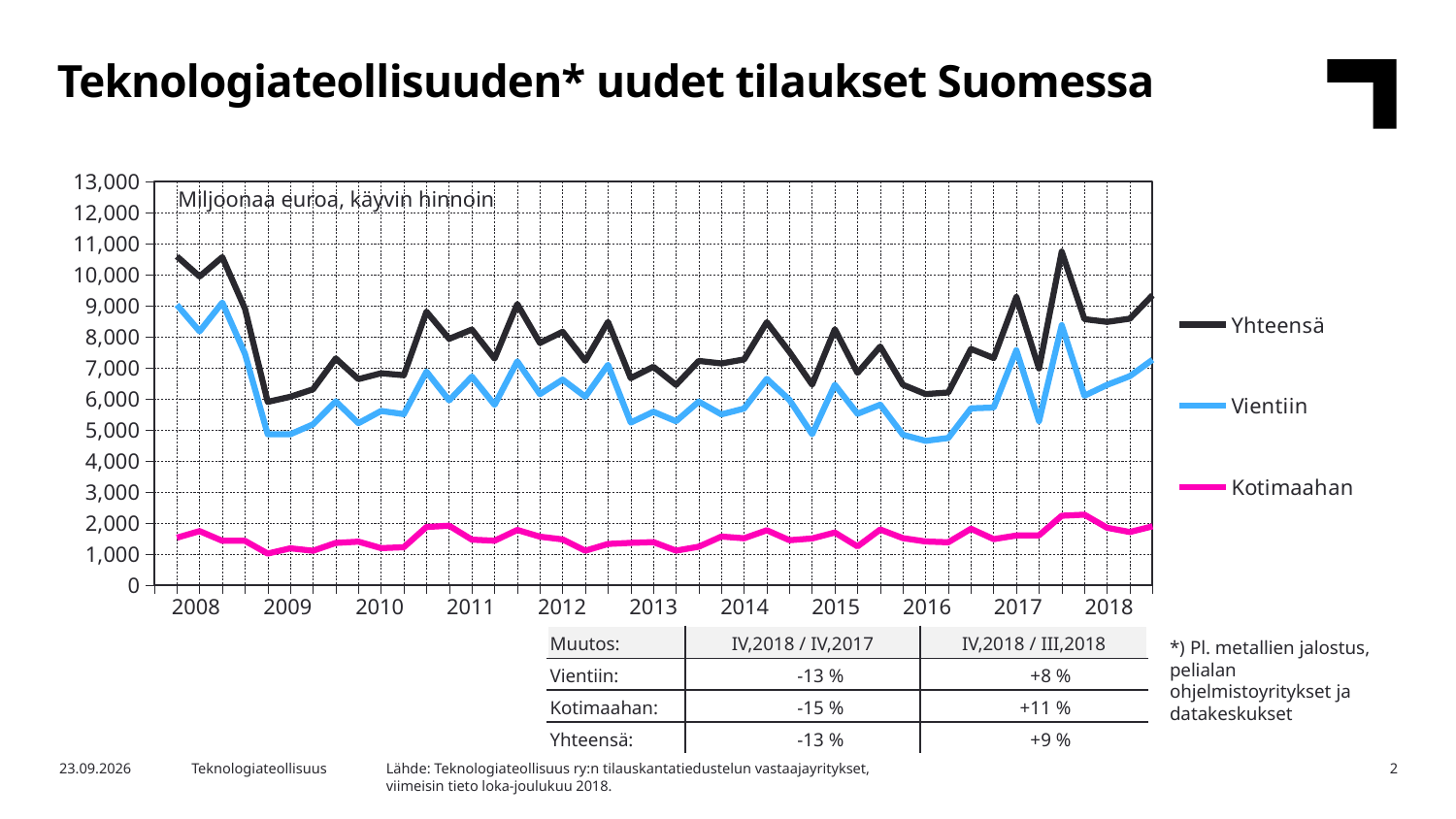
Which series has the lowest values throughout the chart? Kotimaahan Is the value for Kotimaahan at the start of 2008 greater or less than 3,000? less At the start of 2009, which is larger, Vientiin or Kotimaahan? Vientiin Is the lowest value for Vientiin in 2016 greater or less than 5,000? less Does the Yhteensä line rise or fall from the start of 2008 to the start of 2009? fall Which series has the highest values throughout the chart? Yhteensä How many year labels are shown on the x axis? 11 What kind of chart is shown on the slide? line chart What are the three series named in the legend? Yhteensä, Vientiin, Kotimaahan Is the value for Yhteensä at the start of 2008 greater or less than 10,000? greater What unit note is printed inside the chart area? Miljoonaa euroa, käyvin hinnoin How many series does the legend list? 3